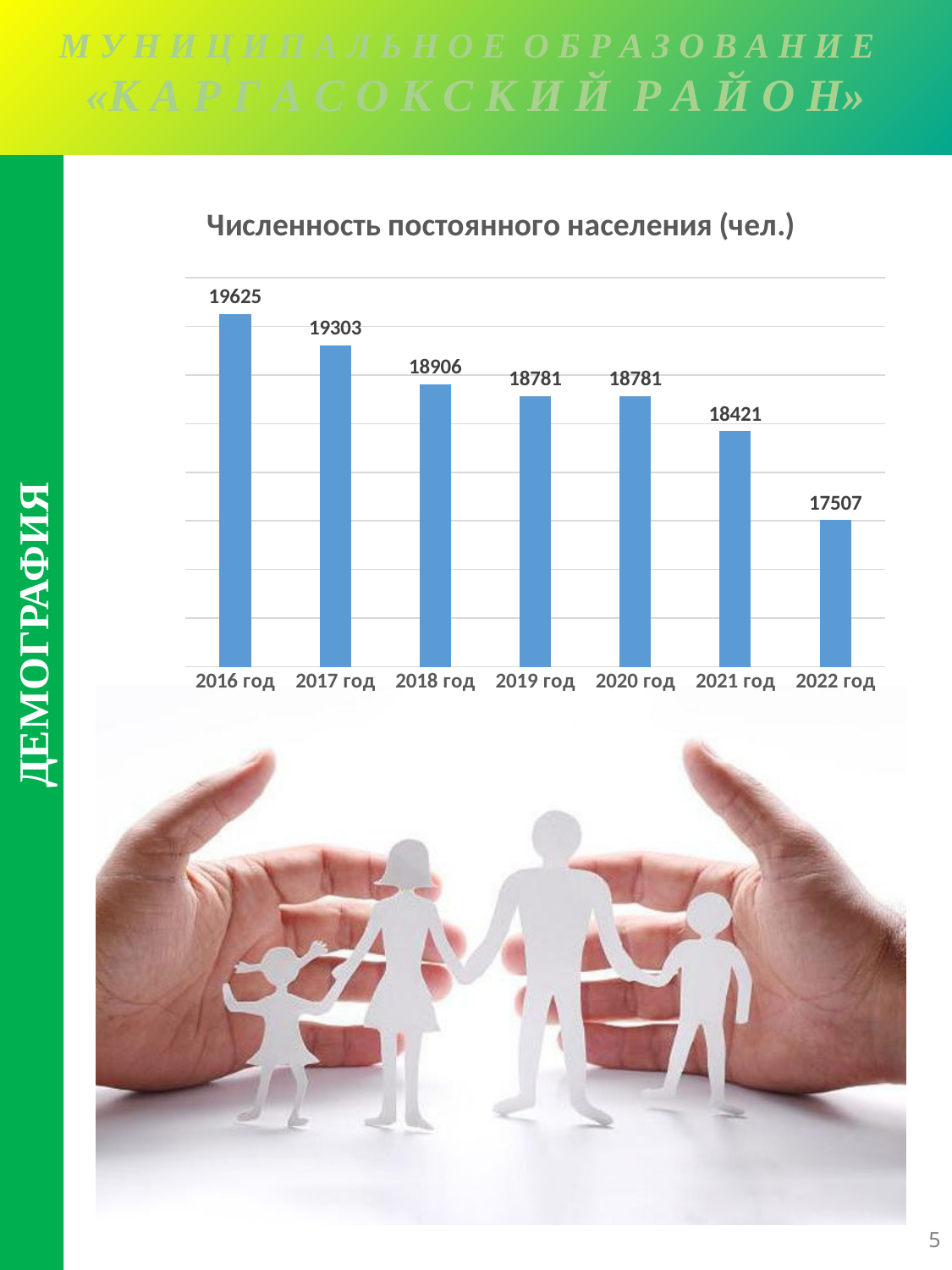
Which year has the highest value? 2016 год What is the value for 2016 год? 19625 What is the value for 2019 год? 18781 Do the values rise or fall from 2016 год to 2022 год? fall How many years are shown on the chart? 7 What is the title of the chart? Численность постоянного населения (чел.) What is the difference between the values for 2020 год and 2021 год? 360 Which year has the lowest value? 2022 год Which is larger, the value for 2017 год or the value for 2018 год? 2017 год What is the difference between the values for 2016 год and 2022 год? 2118 What is the value for 2022 год? 17507 What kind of chart is this? bar chart